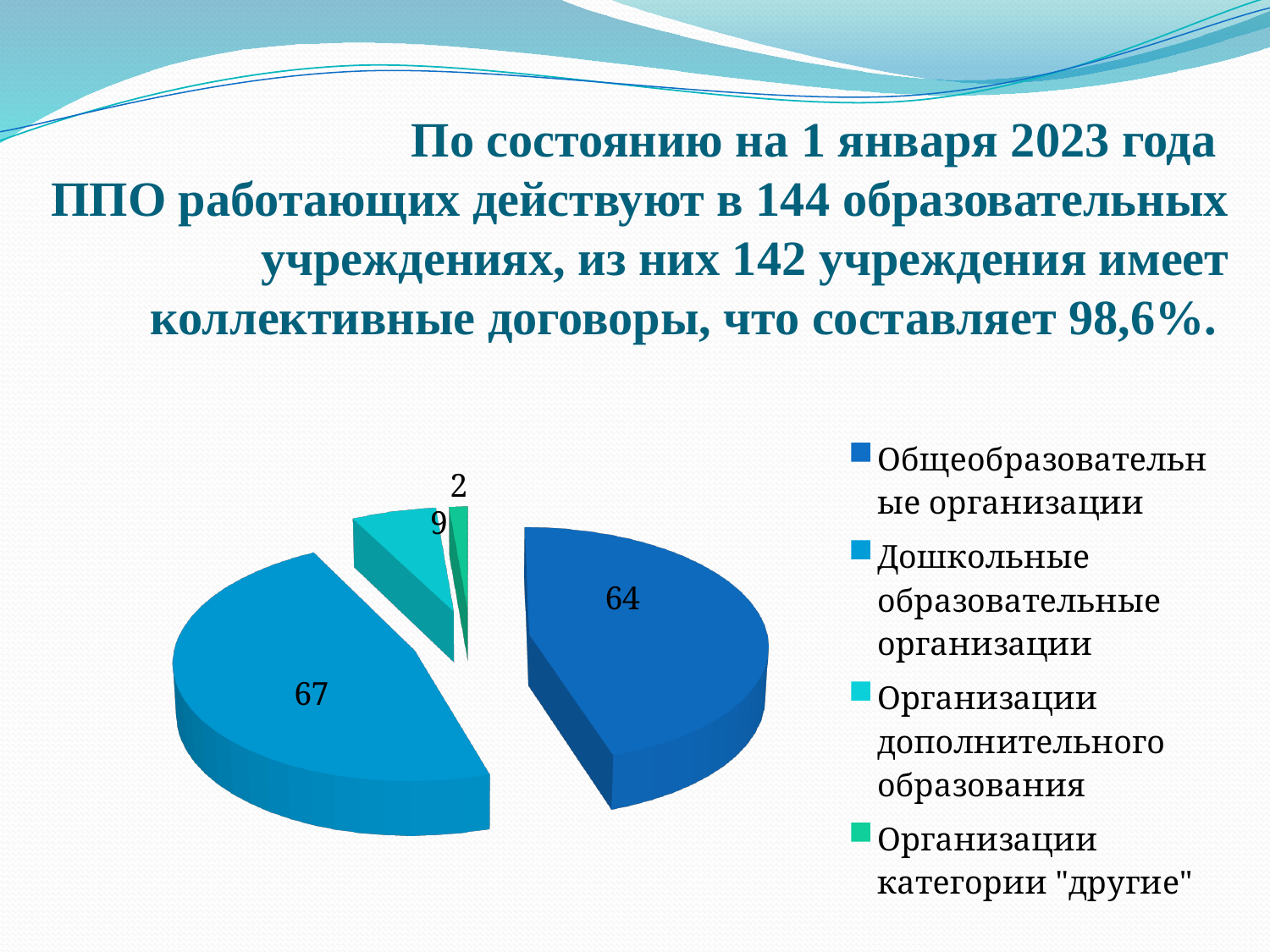
What is the value for Дошкольные образовательные организации in the pie chart? 67 Which is larger: the value for Организации дополнительного образования or the value for Организации категории "другие"? Организации дополнительного образования What is the total of all the values shown in the pie chart? 142 Which category has the largest slice in the pie chart? Дошкольные образовательные организации What is the value for Организации дополнительного образования in the pie chart? 9 What is the value for Общеобразовательные организации in the pie chart? 64 What is the difference between the values for Дошкольные образовательные организации and Общеобразовательные организации? 3 Which category has the smallest slice in the pie chart? Организации категории "другие" How many slices does the pie chart have? 4 What type of chart is shown on the slide? pie chart How many entries does the legend of the pie chart list? 4 What is the value for Организации категории "другие" in the pie chart? 2